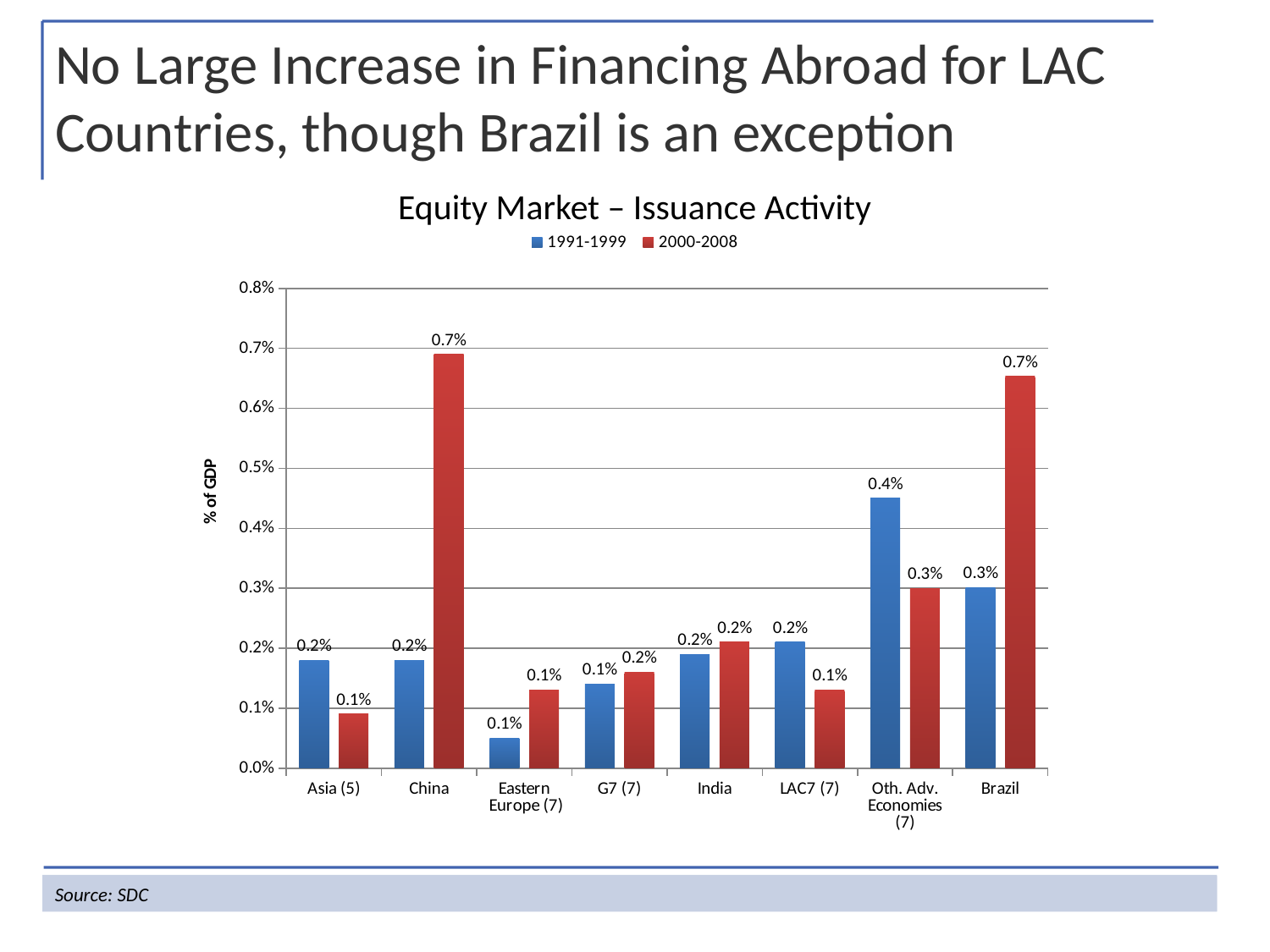
Which category has the highest value in the 1991-1999 series? Oth. Adv. Economies (7) What kind of chart is shown on the slide? bar chart How many categories are shown on the x axis? 8 What is the value for China in the 2000-2008 series? 0.7% Is the 2000-2008 value for China greater or less than 0.5%? greater What is the difference between the 2000-2008 and 1991-1999 values for China? 0.5% What is the value for Brazil in the 1991-1999 series? 0.3% What is the value for Oth. Adv. Economies (7) in the 1991-1999 series? 0.4% How many series does the legend list? 2 For LAC7 (7), which series has the larger value, 1991-1999 or 2000-2008? 1991-1999 Which category has the lowest value in the 1991-1999 series? Eastern Europe (7) What is the difference between the 2000-2008 and 1991-1999 values for Brazil? 0.4%